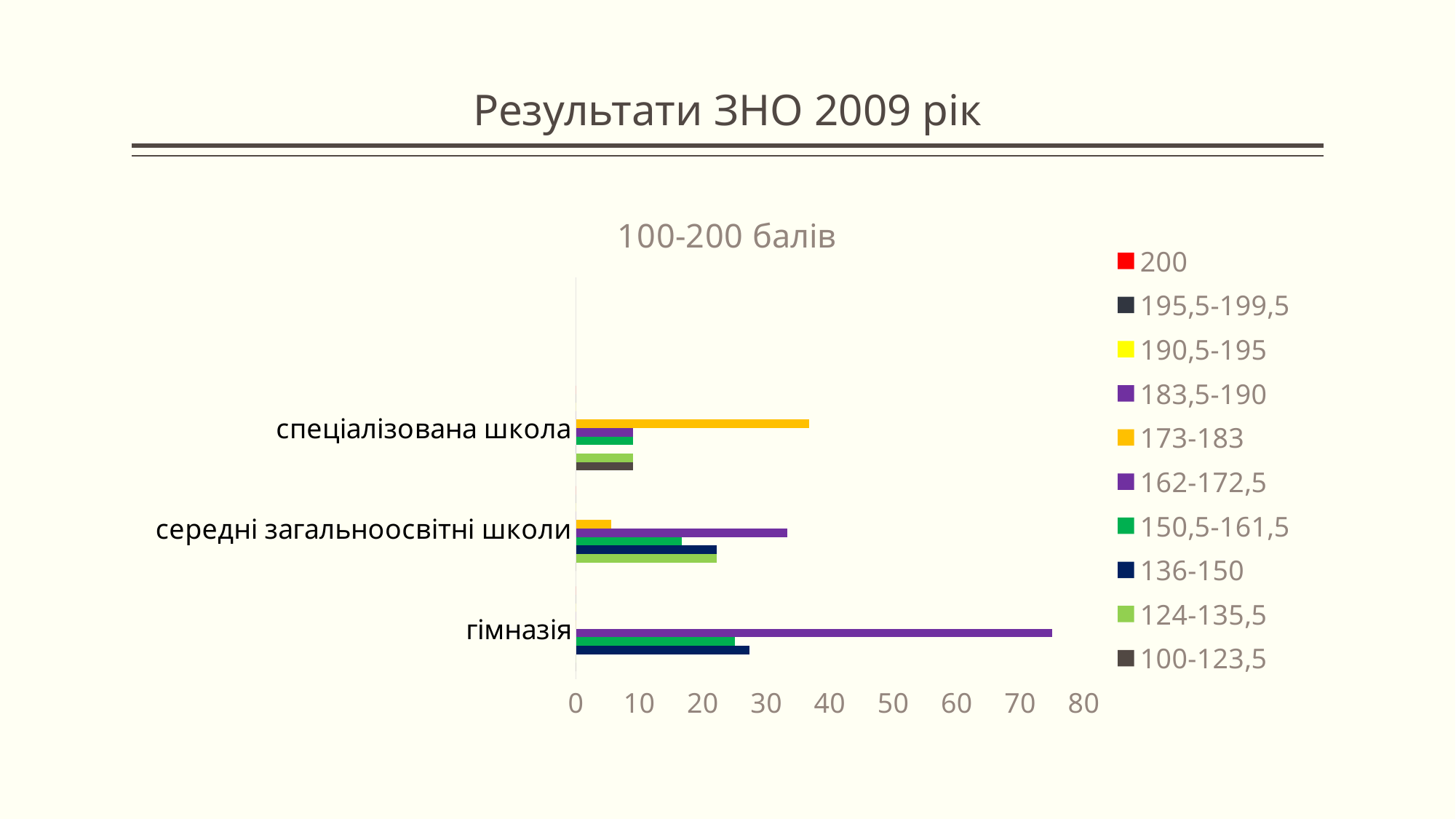
How many school categories are plotted on the chart? 3 Which category contains the longest bar on the chart? гімназія Is the value of the 173-183 series for спеціалізована школа greater or less than 30? greater What kind of chart is shown on the slide? bar chart How many series does the legend list? 10 Is the value of the 173-183 series for середні загальноосвітні школи greater or less than 10? less For the 173-183 series, which category has the larger value: спеціалізована школа or середні загальноосвітні школи? спеціалізована школа What is the title of the chart? 100-200 балів Is the value of the 150,5-161,5 series for спеціалізована школа greater or less than 20? less For the 136-150 series, which category has the larger value: гімназія or спеціалізована школа? гімназія